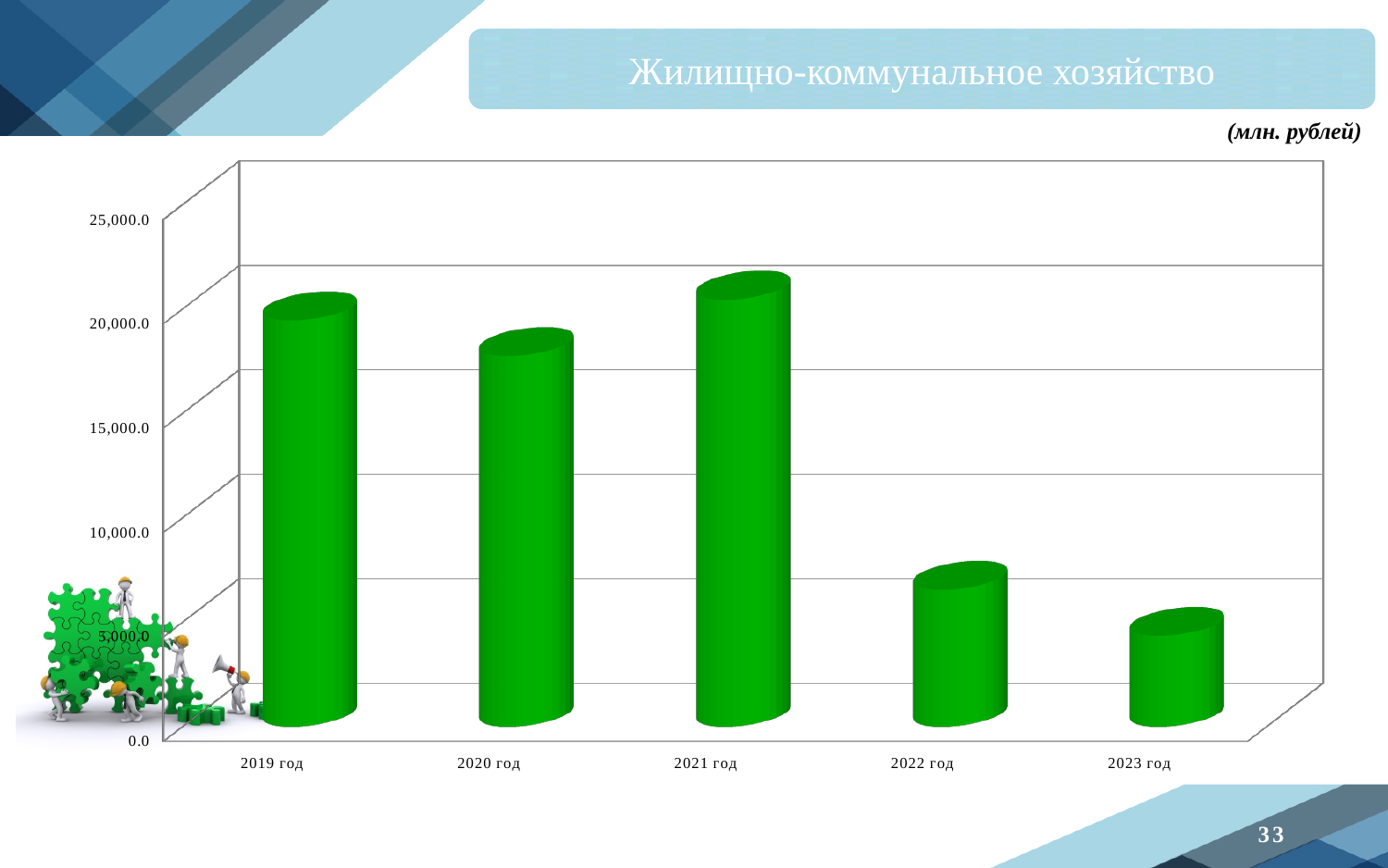
Is the value for 2020 год greater or less than 20,000.0? less How many categories (years) are shown on the x axis of the chart? 5 Which year has the lowest value in the chart? 2023 год Which year has the highest value in the chart? 2021 год Which is larger, the value for 2021 год or the value for 2022 год? 2021 год Is the value for 2022 год greater or less than 10,000.0? less What kind of chart is shown on the slide? bar chart Which is larger, the value for 2019 год or the value for 2020 год? 2019 год What is the title of the chart on the slide? Жилищно-коммунальное хозяйство Is the value for 2022 год greater or less than 5,000.0? greater Do the values generally rise or fall from 2021 год to 2023 год? fall